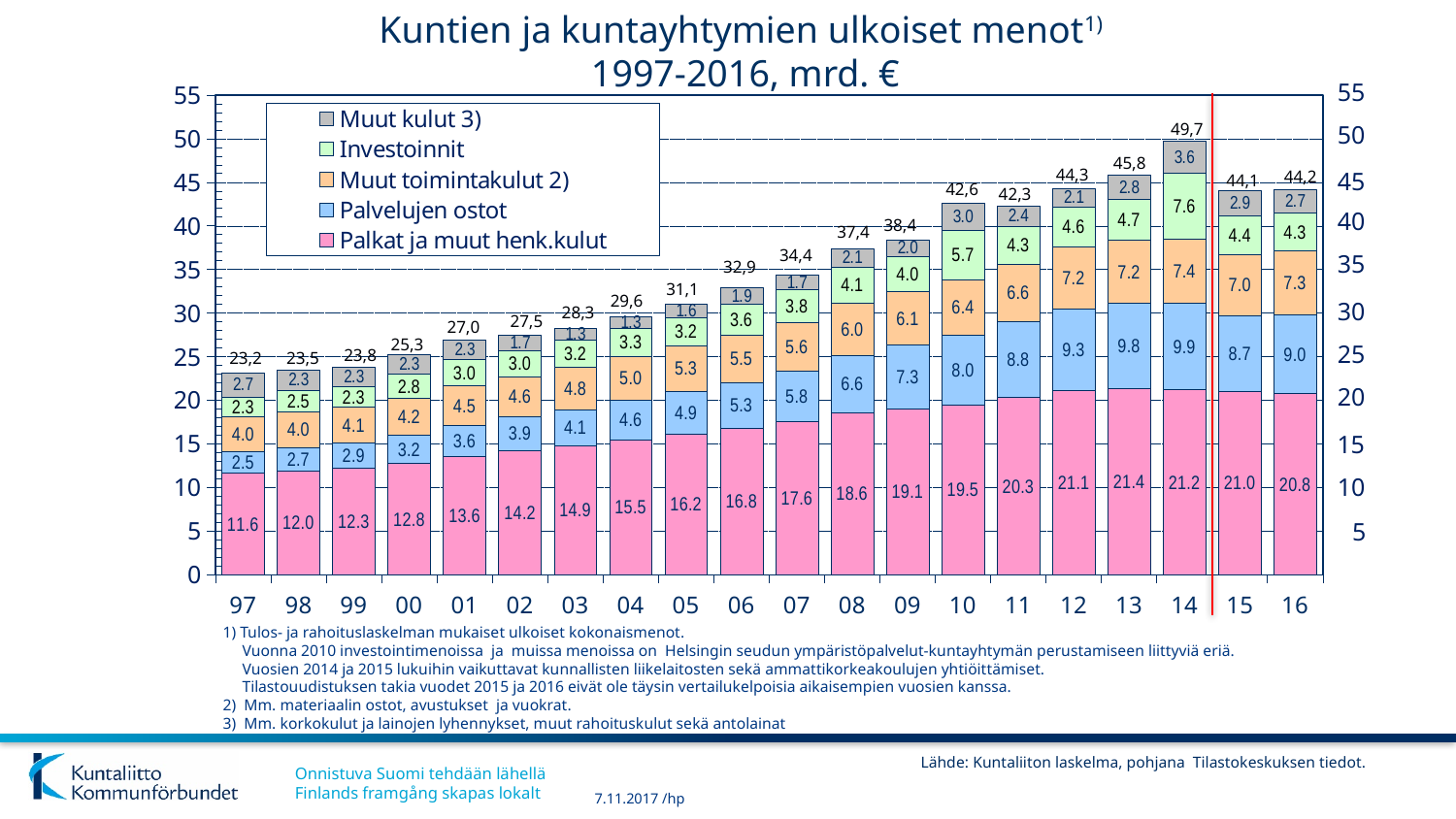
What is the value of Investoinnit for year 14? 7.6 What is the value of Palkat ja muut henk.kulut for year 16? 20.8 How many series does the legend list? 5 How many years (bars) are shown on the chart? 20 Which year has the lowest total external expenditure? 97 Do the total external expenditures generally rise or fall from year 97 to year 14? Rise Which year has the highest total external expenditure? 14 What is the total labelled above the stacked bar for year 14? 49,7 Which is larger, Palvelujen ostot in year 13 or in year 15? Year 13 What kind of chart is shown on the slide? Stacked bar chart What is the value of Palvelujen ostot for year 10? 8.0 By how much did Palkat ja muut henk.kulut increase from year 97 to year 16? 9.2